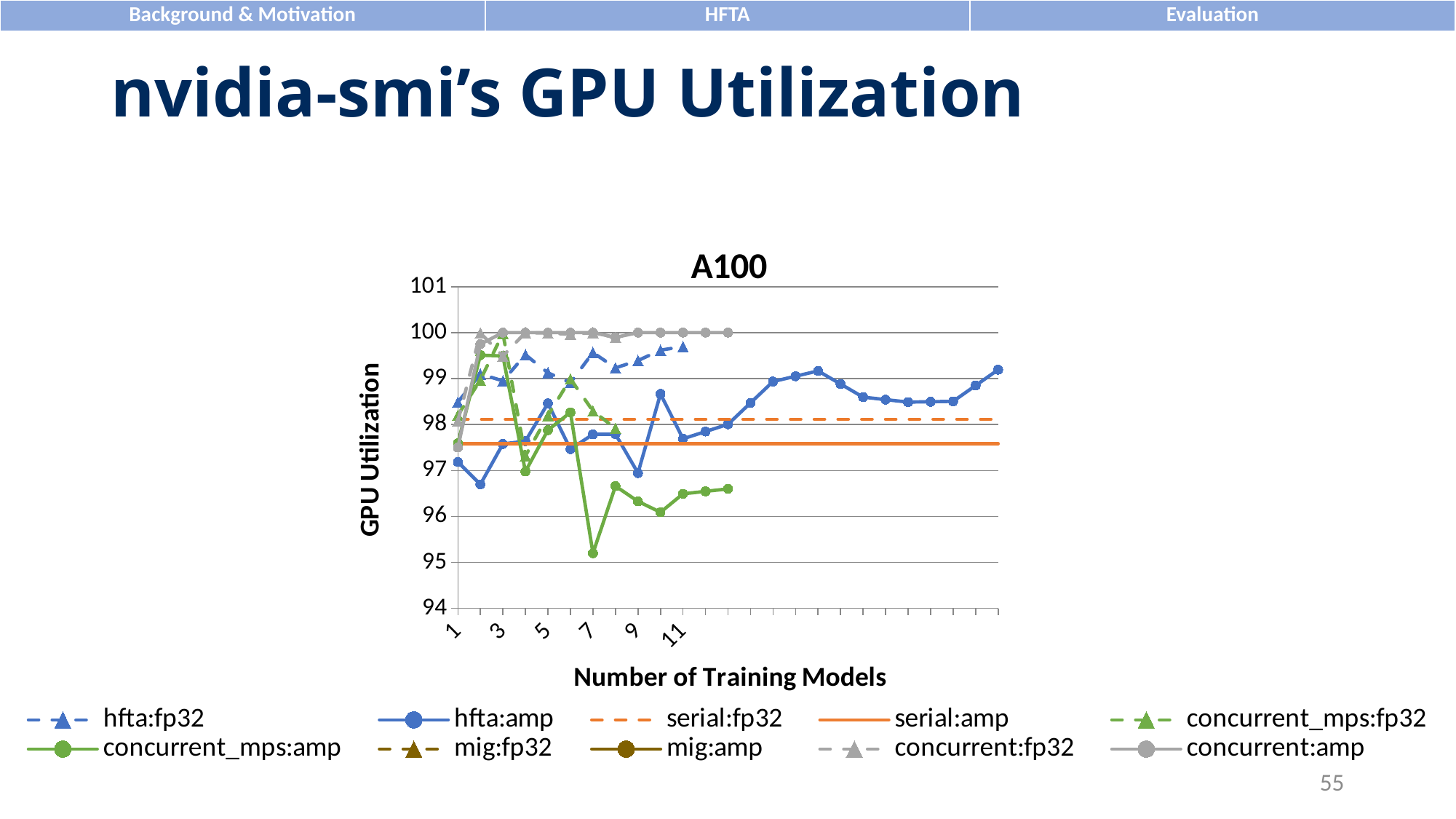
How many series does the chart's legend list? 10 At 9 training models, which is larger: concurrent:amp or concurrent_mps:amp? concurrent:amp Does the concurrent:amp series rise or fall from 1 to 3 training models? rise Is the value for hfta:amp at 2 training models greater or less than 97? less Which series reaches the lowest GPU utilization value on the chart? concurrent_mps:amp What is the title of the chart? A100 What is the label of the x axis? Number of Training Models Is the value of the serial:amp line greater or less than 98? less Is the value for concurrent_mps:amp at 7 training models greater or less than 96? less What type of chart is shown on the slide? line chart Does the hfta:amp series rise or fall from 1 to 2 training models? fall